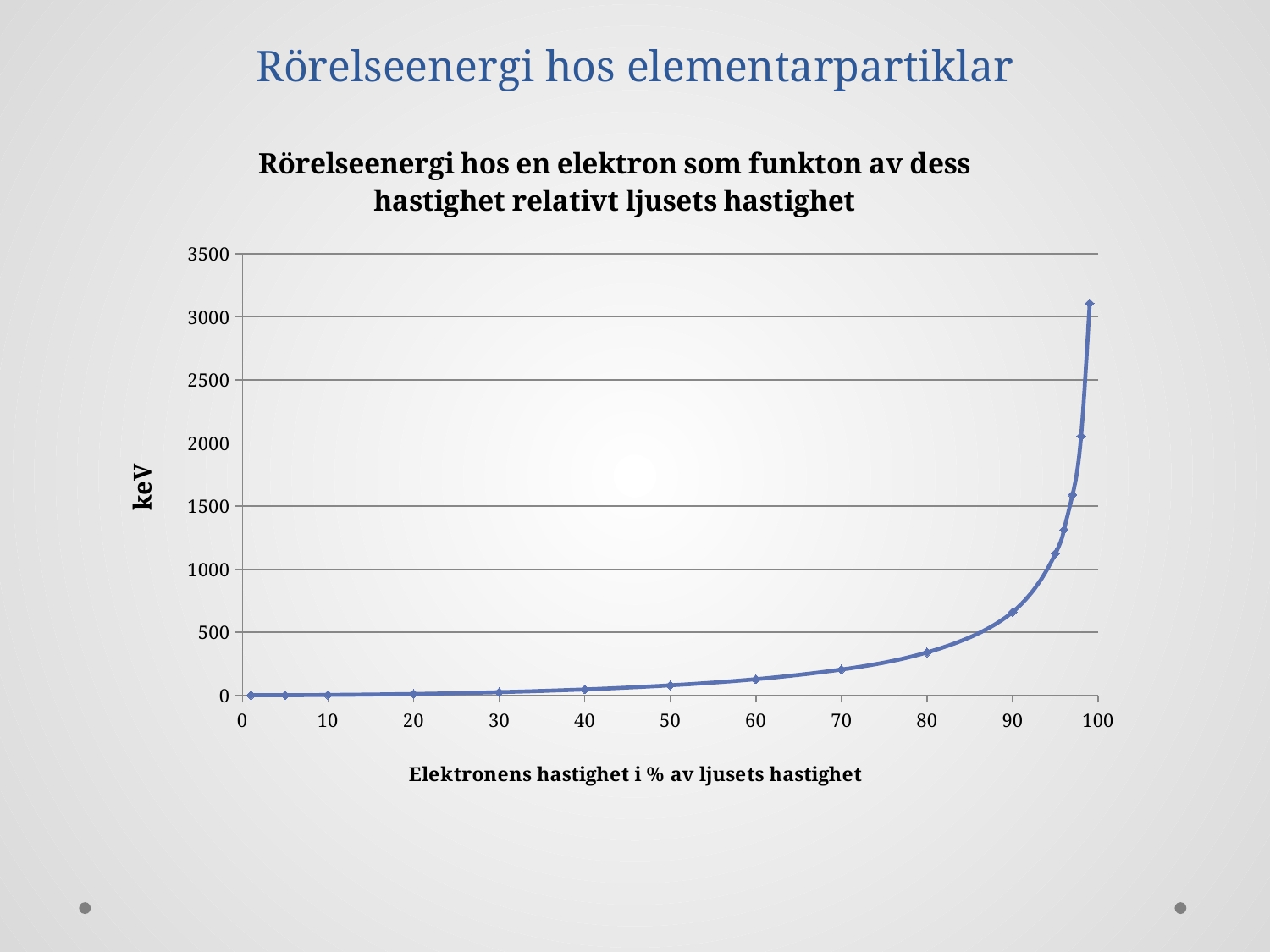
Is the value at 70% of the speed of light greater or less than 500 keV? less Is the highest plotted value greater or less than 2500 keV? greater What is the label on the x axis of the chart? Elektronens hastighet i % av ljusets hastighet Is the value at 90% of the speed of light greater or less than 500 keV? greater Do the values rise or fall as the electron's speed (x axis) increases? rise What is the label on the y axis of the chart? keV What kind of chart is shown on the slide? line chart Which is larger, the value at 90% or the value at 80% of the speed of light? 90%